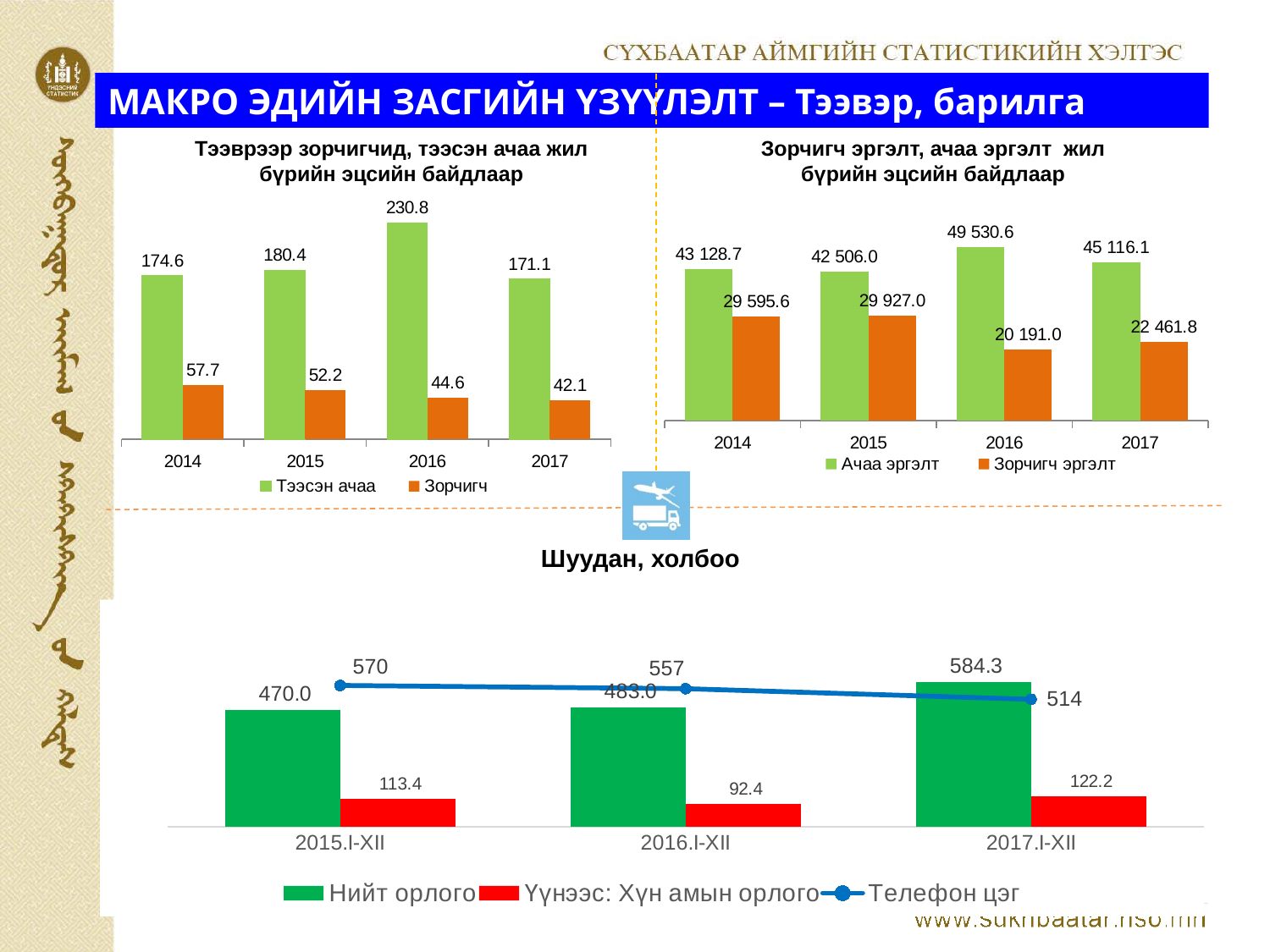
In the chart 'Шуудан, холбоо', how many categories are shown on the x axis? 3 In the chart 'Шуудан, холбоо', what is the value of Нийт орлого for 2017.I-XII? 584.3 In the chart 'Зорчигч эргэлт, ачаа эргэлт жил бүрийн эцсийн байдлаар', which year has the lowest Зорчигч эргэлт value? 2016 In the chart 'Зорчигч эргэлт, ачаа эргэлт жил бүрийн эцсийн байдлаар', which is larger: Зорчигч эргэлт in 2014 or in 2015? 2015 In the chart 'Тээврээр зорчигчид, тээсэн ачаа жил бүрийн эцсийн байдлаар', what is the value of Тээсэн ачаа in 2016? 230.8 In the chart 'Тээврээр зорчигчид, тээсэн ачаа жил бүрийн эцсийн байдлаар', which year has the lowest Зорчигч value? 2017 In the chart 'Зорчигч эргэлт, ачаа эргэлт жил бүрийн эцсийн байдлаар', what is the value of Ачаа эргэлт in 2016? 49 530.6 In the chart 'Зорчигч эргэлт, ачаа эргэлт жил бүрийн эцсийн байдлаар', how many series does the legend list? 2 In the chart 'Шуудан, холбоо', what is the value of Телефон цэг for 2016.I-XII? 557 In the chart 'Тээврээр зорчигчид, тээсэн ачаа жил бүрийн эцсийн байдлаар', what is the difference between the Тээсэн ачаа values for 2015 and 2014? 5.8 In the chart 'Шуудан, холбоо', which period has the lowest value for Үүнээс: Хүн амын орлого? 2016.I-XII In the chart 'Тээврээр зорчигчид, тээсэн ачаа жил бүрийн эцсийн байдлаар', does the Зорчигч series rise or fall from 2014 to 2017? fall